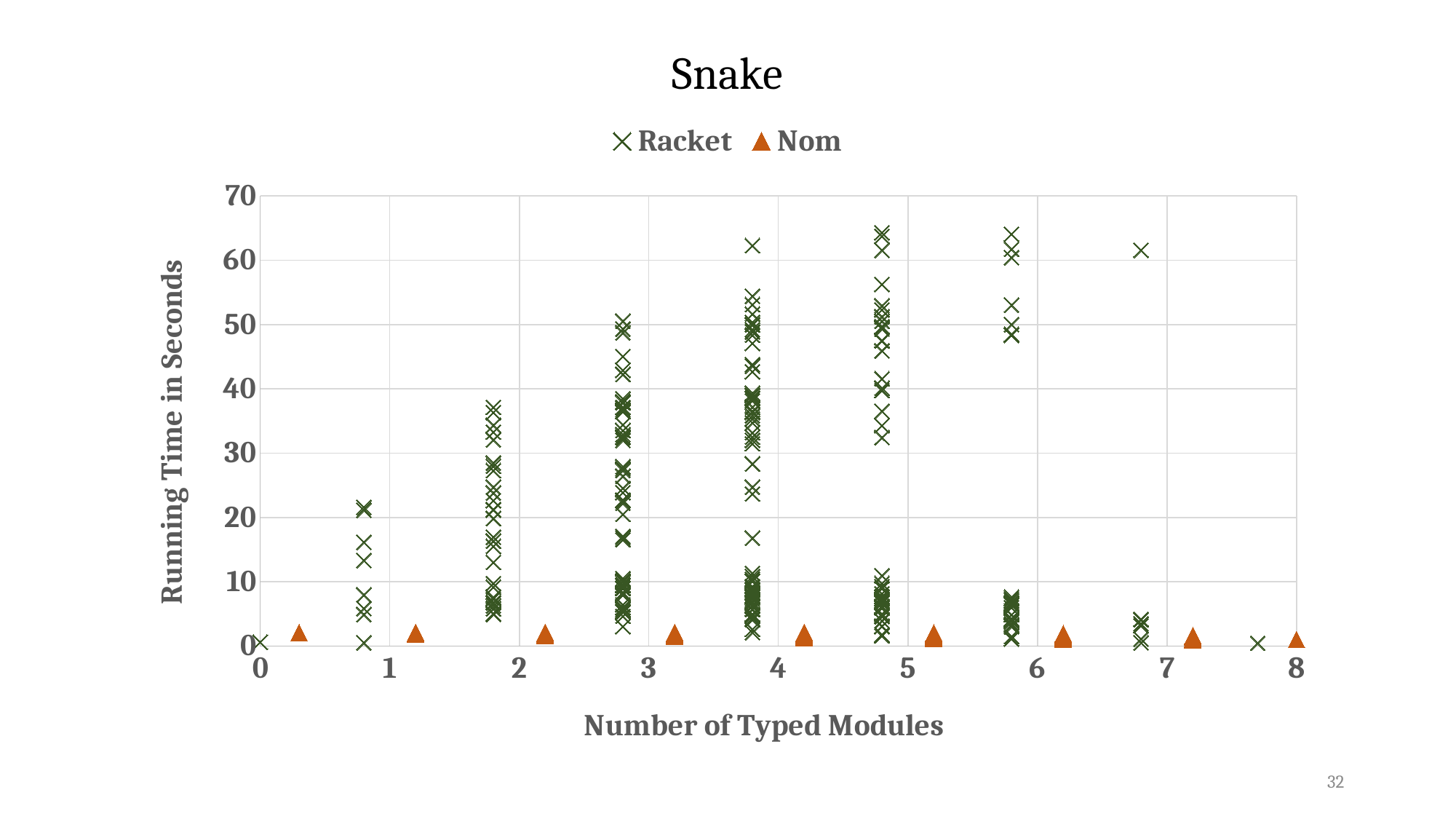
What is the label of the y axis? Running Time in Seconds Do the Nom running times rise, fall, or stay roughly flat as the number of typed modules increases? stay roughly flat Is the Nom running time at 8 typed modules greater or less than 10 seconds? less What kind of chart is shown on the slide? scatter chart Which series is plotted with orange triangles? Nom Is the highest Racket running time at 5 typed modules greater or less than 60 seconds? greater Which series reaches the higher running time at 5 typed modules, Racket or Nom? Racket Which series has the lower running times across all numbers of typed modules? Nom What is the title of the chart? Snake How many series does the legend list? 2 Is the Racket running time at 8 typed modules greater or less than 10 seconds? less